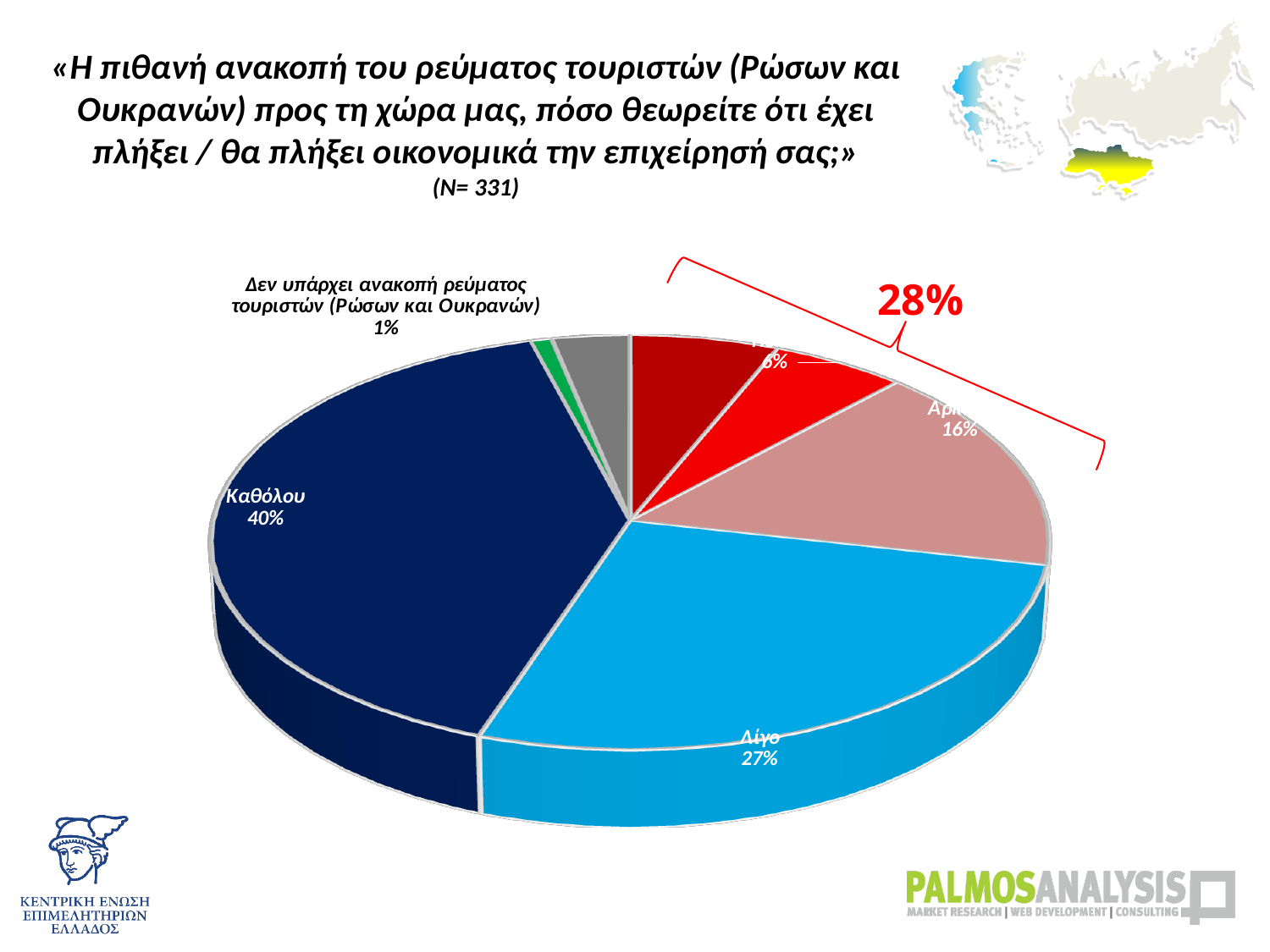
How many slices does the pie chart have? 7 Which response category has the largest slice of the pie? Καθόλου What is the sample size (N) stated under the chart title? 331 By how many percentage points does "Καθόλου" exceed "Λίγο"? 13 percentage points What combined percentage is indicated by the red bracket above the pie? 28% Which slice is larger, "Καθόλου" or "Λίγο"? Καθόλου What kind of chart is shown on the slide? pie chart What percentage of respondents answered "Καθόλου"? 40% What share of the pie is labelled "Δεν υπάρχει ανακοπή ρεύματος τουριστών (Ρώσων και Ουκρανών)"? 1% What percentage of respondents answered "Λίγο"? 27%